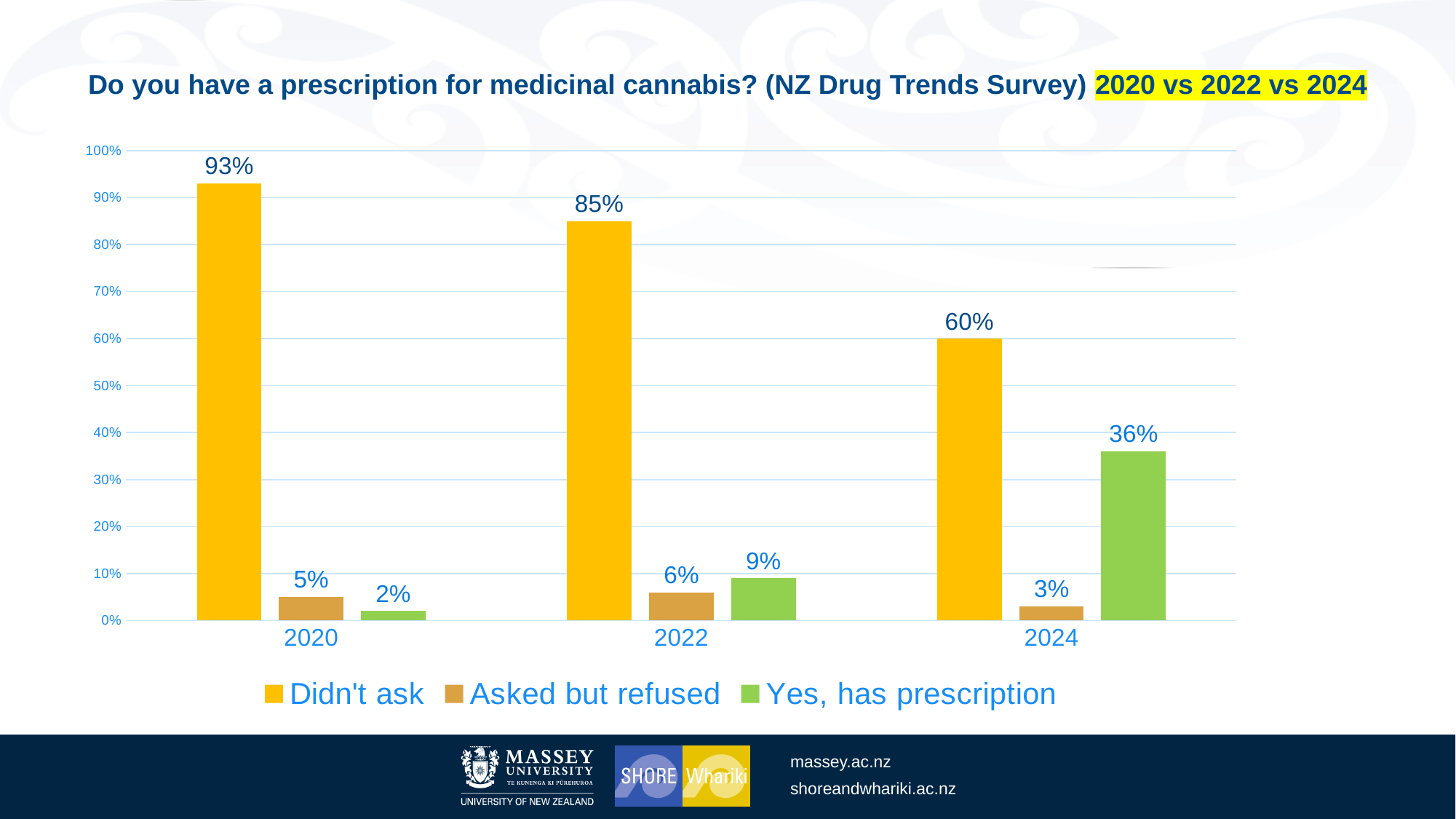
How many series does the legend list? 3 Which is larger in 2022: 'Asked but refused' or 'Yes, has prescription'? Yes, has prescription What is the value for 'Asked but refused' in 2022? 6% Is the 'Didn't ask' value for 2022 greater or less than 80%? greater What is the difference between the 'Didn't ask' values for 2020 and 2024? 33 percentage points What is the value for 'Didn't ask' in 2020? 93% In which year is the 'Yes, has prescription' value highest? 2024 Does the 'Didn't ask' value rise or fall from 2020 to 2024? Fall What kind of chart is shown on the slide? Bar chart What percentage of respondents in 2024 said 'Yes, has prescription'? 36% How many years are shown on the x axis? 3 In which year is the 'Didn't ask' value lowest? 2024